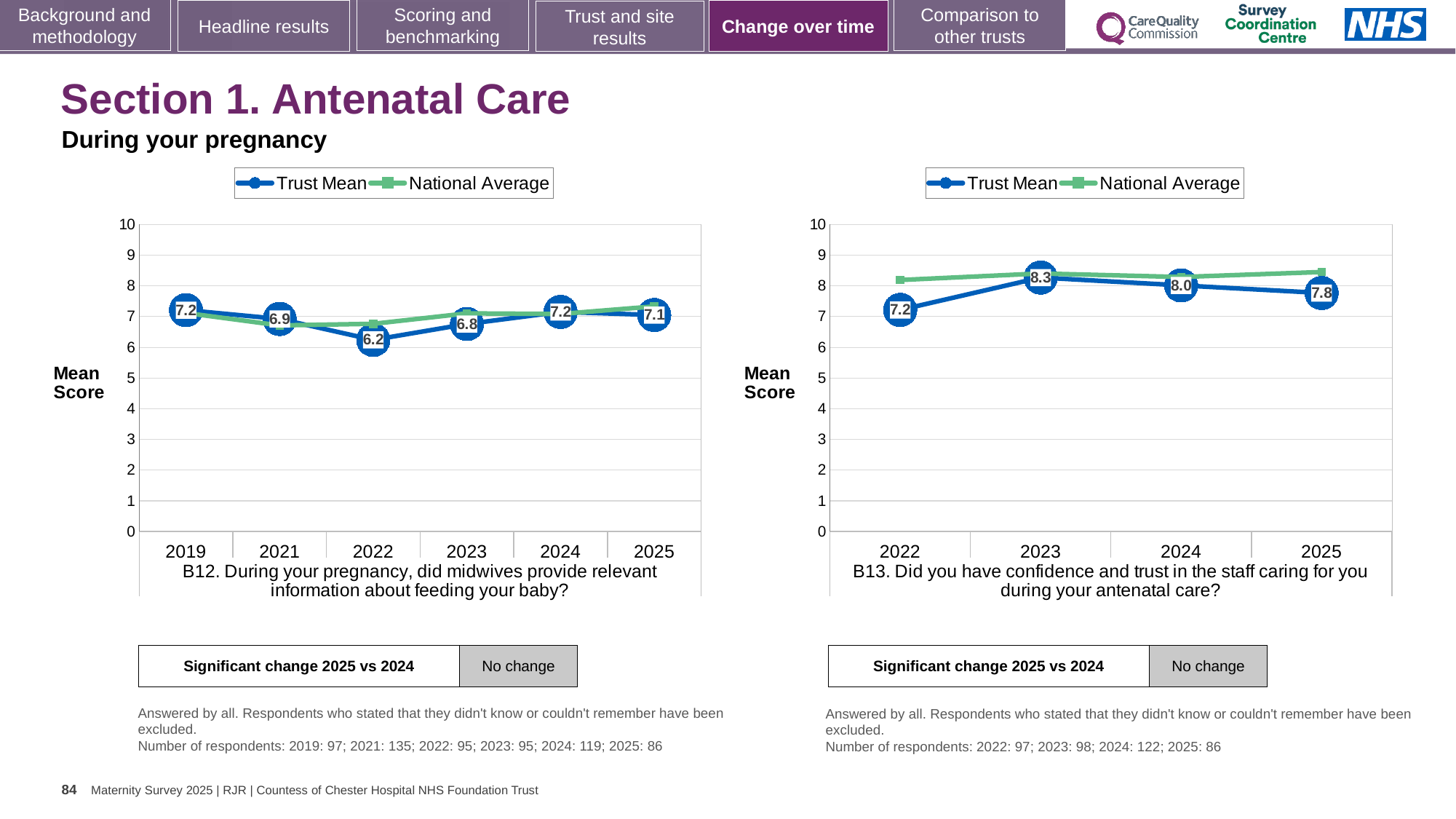
In the B12 chart (left), how many years are plotted on the x axis? 6 In the B13 chart (right), is the Trust Mean score for 2022 larger or smaller than the score for 2025? smaller What type of chart is used for the B13 chart (right)? Line chart In the B12 chart (left), what is the Trust Mean score for 2025? 7.1 In the B13 chart (right), what is the difference between the Trust Mean scores for 2023 and 2022? 1.1 In the B13 chart (right), what is the Trust Mean score for 2023? 8.3 In the B12 chart (left), what is the Trust Mean score for 2022? 6.2 In the B13 chart (right), which year has the highest Trust Mean score? 2023 In the B12 chart (left), which year has the lowest Trust Mean score? 2022 In the B12 chart (left), is the National Average for 2022 greater or less than 8? less In the B12 chart (left), what is the difference between the Trust Mean scores for 2024 and 2022? 1.0 In the B13 chart (right), how many series does the legend list? 2